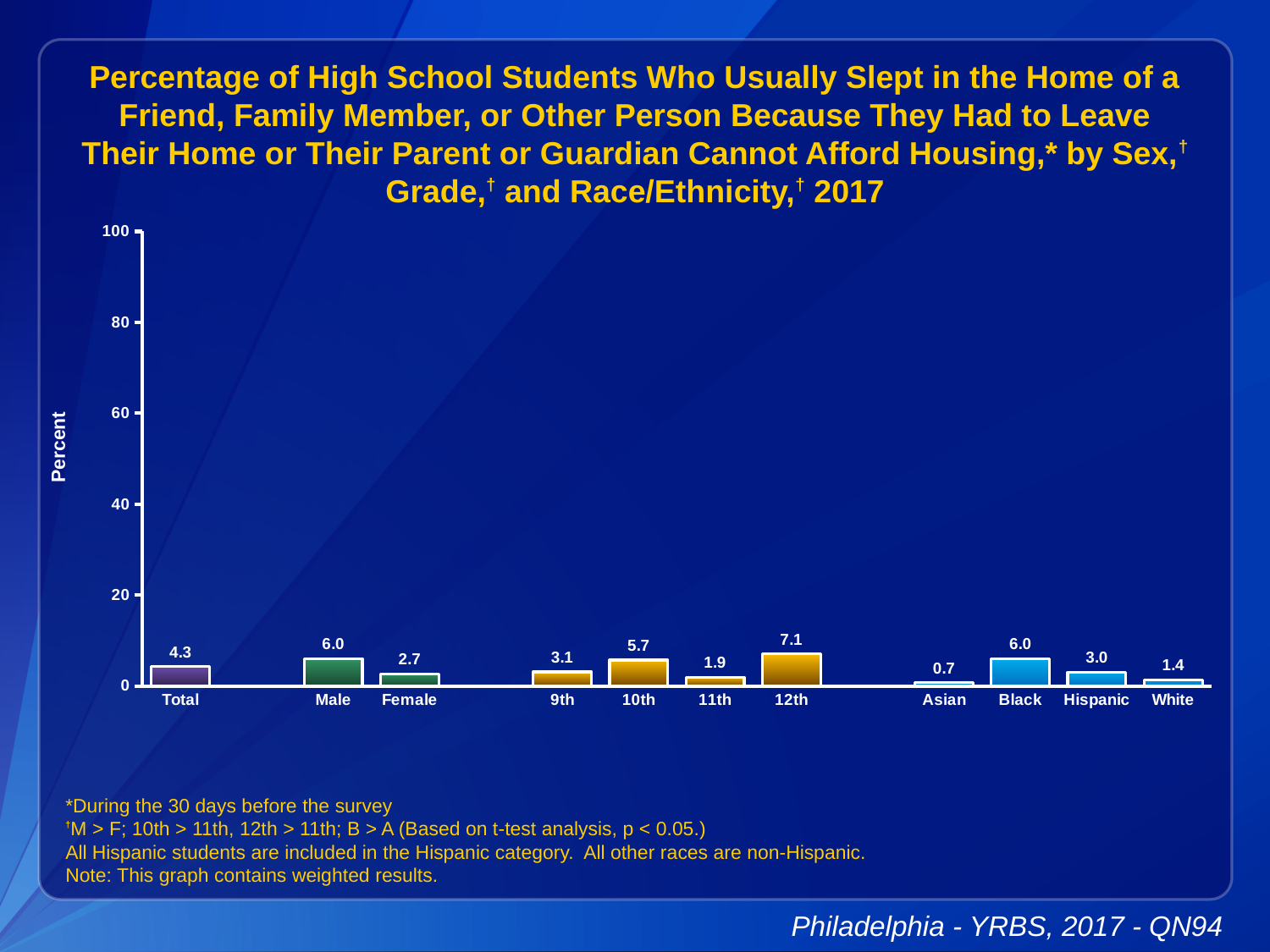
What is the value for 11th grade? 1.9 What is the value for Total? 4.3 How many categories are shown on the x axis? 11 Which category has the lowest value? Asian Is the value for Black students greater or less than 20? less What is the difference between the Male and Female values? 3.3 What kind of chart is this? bar chart What is the value for Asian students? 0.7 What is the label on the y axis? Percent Which category has the highest value? 12th What is the value for Male? 6.0 Which is larger, the value for 10th grade or the value for 9th grade? 10th